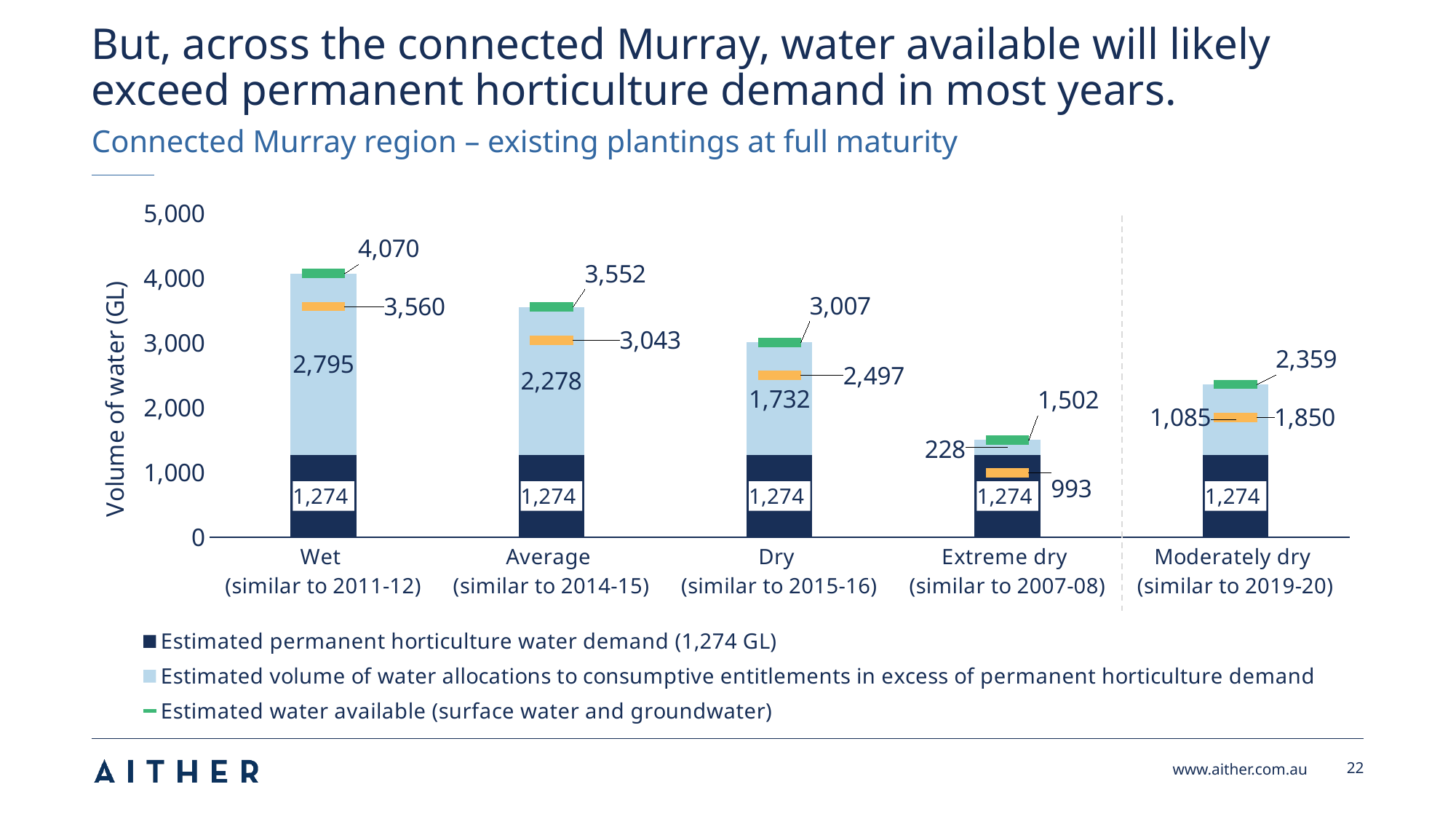
What is the difference between the estimated water available for the Wet scenario and the Dry scenario? 1,063 What is the estimated water available (surface water and groundwater) for the Wet scenario? 4,070 Which scenario has the lowest estimated volume of water allocations in excess of permanent horticulture demand? Extreme dry What is the estimated volume of water allocations in excess of permanent horticulture demand for the Dry scenario? 1,732 How many scenarios are shown on the x axis? 5 What is the total height of the stacked bar for the Extreme dry scenario (demand plus excess allocations)? 1,502 Is the estimated water available larger for the Dry scenario or the Moderately dry scenario? Dry Which scenario has the highest estimated water available (surface water and groundwater)? Wet Is the total height of the stacked bar for the Moderately dry scenario greater or less than 2,000? greater How many series does the legend list? 3 What kind of chart is shown on the slide? Stacked bar chart What is the estimated permanent horticulture water demand shown for the Moderately dry scenario? 1,274